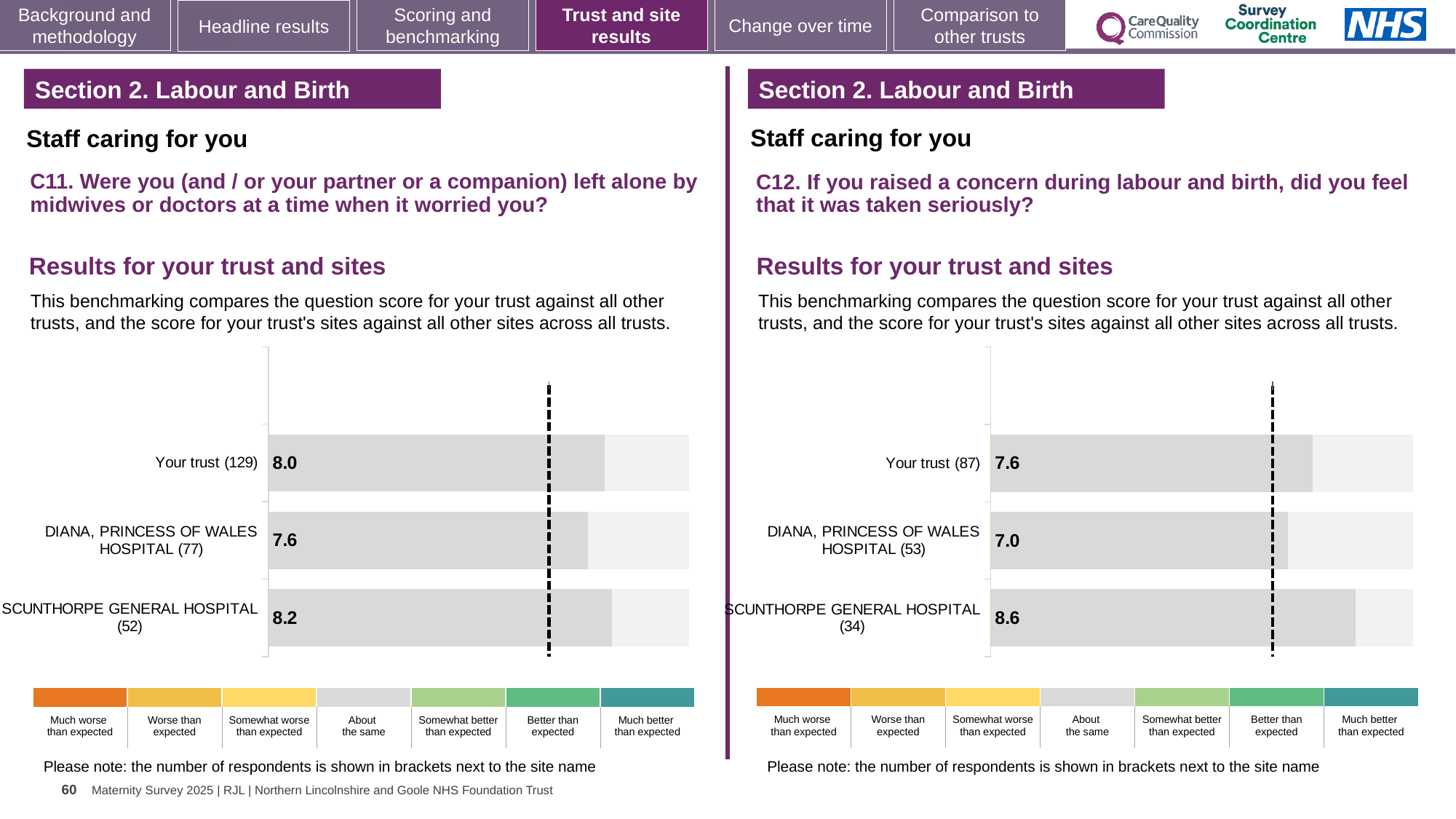
In the C11 chart on the left, which site or trust has the highest score? Scunthorpe General Hospital In the C12 chart on the right, is the score for Diana, Princess of Wales Hospital larger or smaller than the score for Your trust? smaller In the C11 chart on the left, what is the score for Your trust? 8.0 In the C12 chart on the right, what is the score for Your trust? 7.6 In the C12 chart on the right, what is the score for Scunthorpe General Hospital? 8.6 In the C11 chart on the left, what is the difference between the scores for Scunthorpe General Hospital and Diana, Princess of Wales Hospital? 0.6 In the C12 chart on the right, how many respondents are shown in brackets for Your trust? 87 In the C11 chart on the left, how many bars are plotted? 3 What type of chart is used on the left side of the slide for C11? Bar chart In the C12 chart on the right, what is the difference between the scores for Scunthorpe General Hospital and Your trust? 1.0 In the C12 chart on the right, which site or trust has the lowest score? Diana, Princess of Wales Hospital In the C11 chart on the left, what is the score for Diana, Princess of Wales Hospital? 7.6